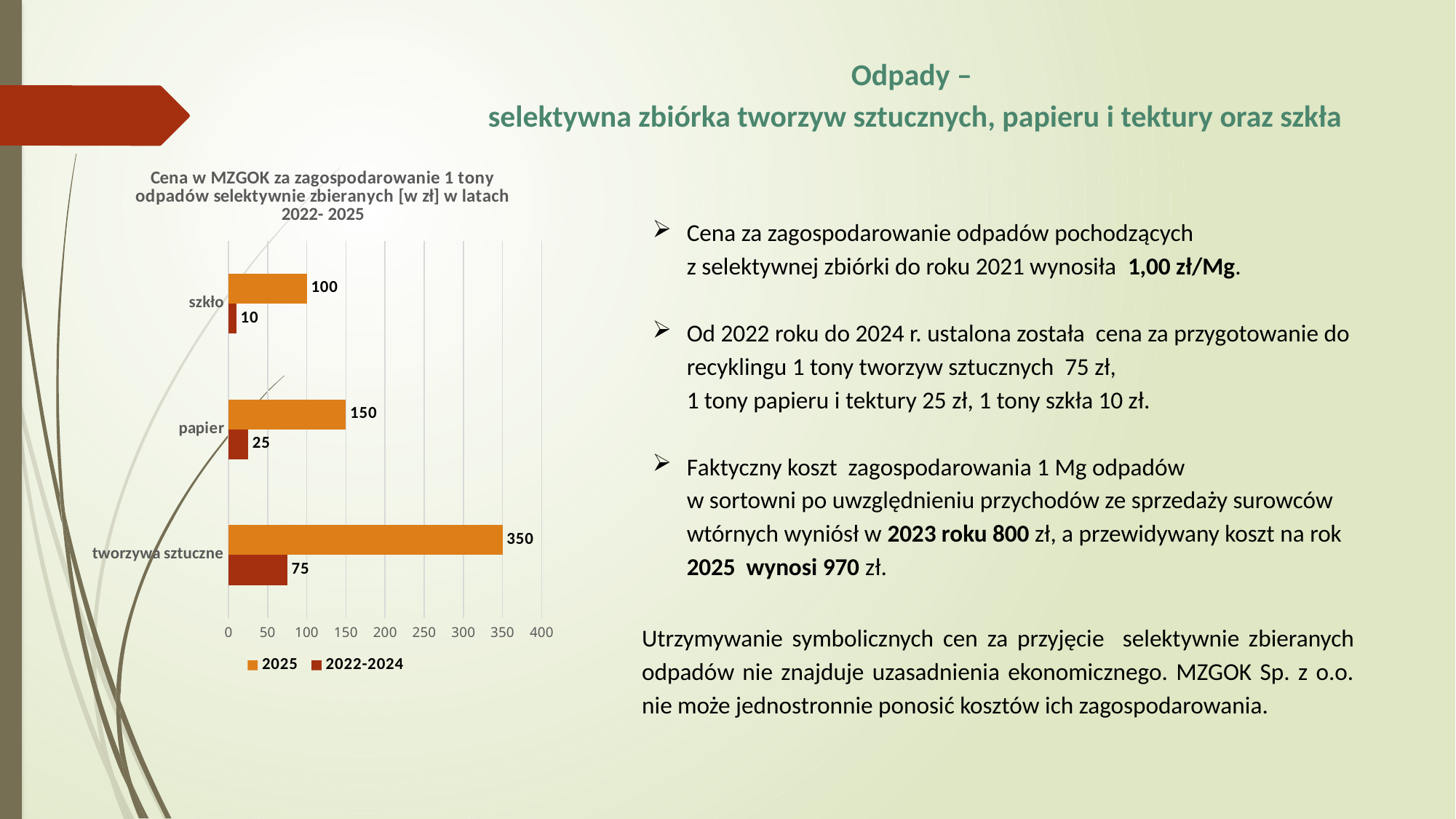
Which category has the lowest 2022-2024 value? szkło What is the 2025 value for tworzywa sztuczne? 350 How many categories are shown on the chart? 3 Which is larger: the 2025 value for papier or the 2025 value for szkło? papier Which category has the highest 2025 value? tworzywa sztuczne What is the 2025 value for szkło? 100 Which series is shown in orange in the legend? 2025 What is the difference between the 2025 and 2022-2024 values for tworzywa sztuczne? 275 What kind of chart is shown on the slide? bar chart What is the 2022-2024 value for papier? 25 How many series does the legend list? 2 What is the 2022-2024 value for szkło? 10